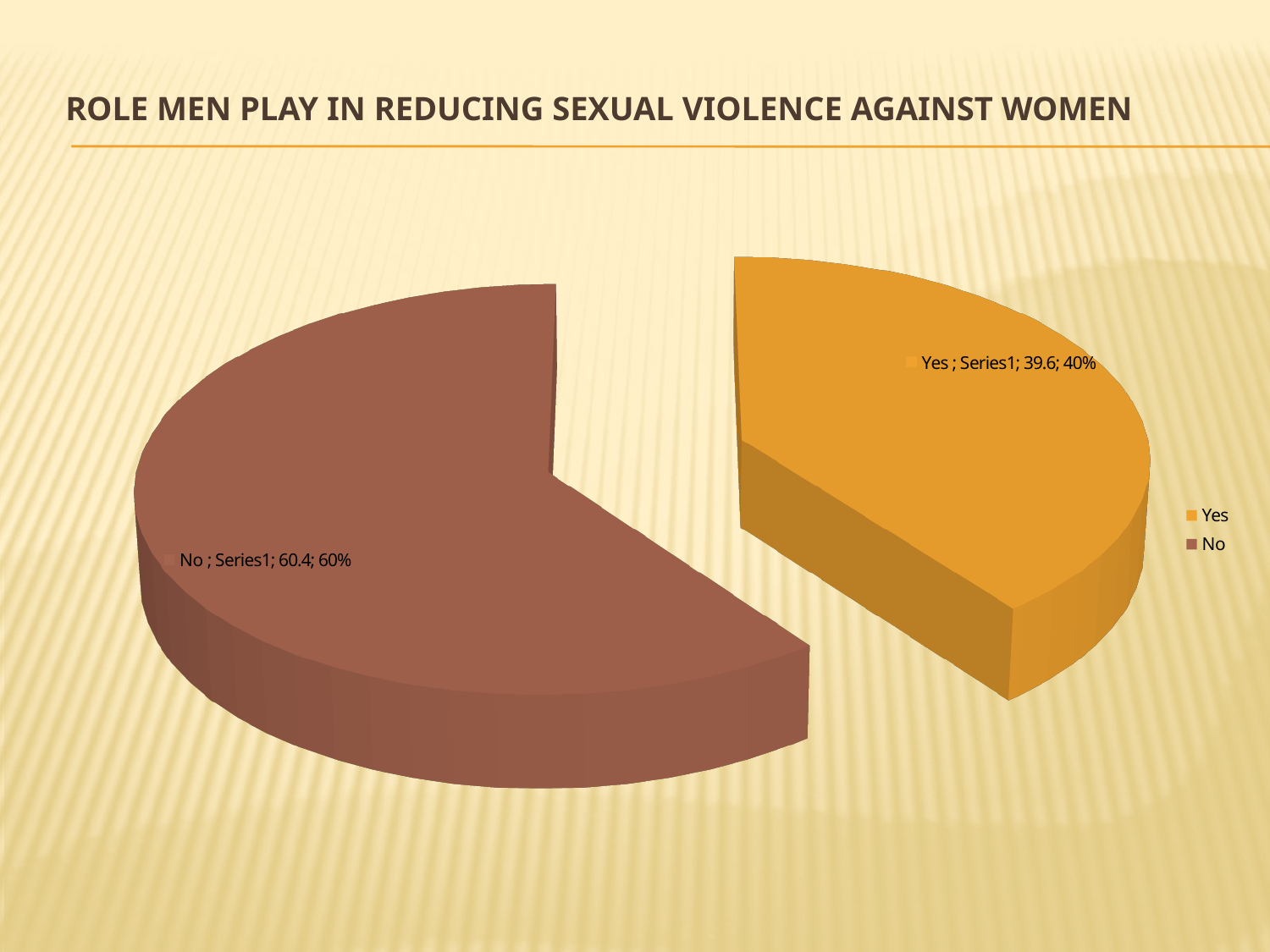
What percentage share of the pie does the No slice represent? 60% What kind of chart is shown on the slide? Pie chart What is the value for the No slice? 60.4 Which is larger, the Yes slice or the No slice? No Which slice is the smallest? Yes What is the difference between the No value and the Yes value? 20.8 What is the title of the chart? ROLE MEN PLAY IN REDUCING SEXUAL VIOLENCE AGAINST WOMEN How many slices does the pie chart have? 2 What is the value for the Yes slice? 39.6 What percentage share of the pie does the Yes slice represent? 40% What colour is the Yes slice? Orange Which slice is the largest? No